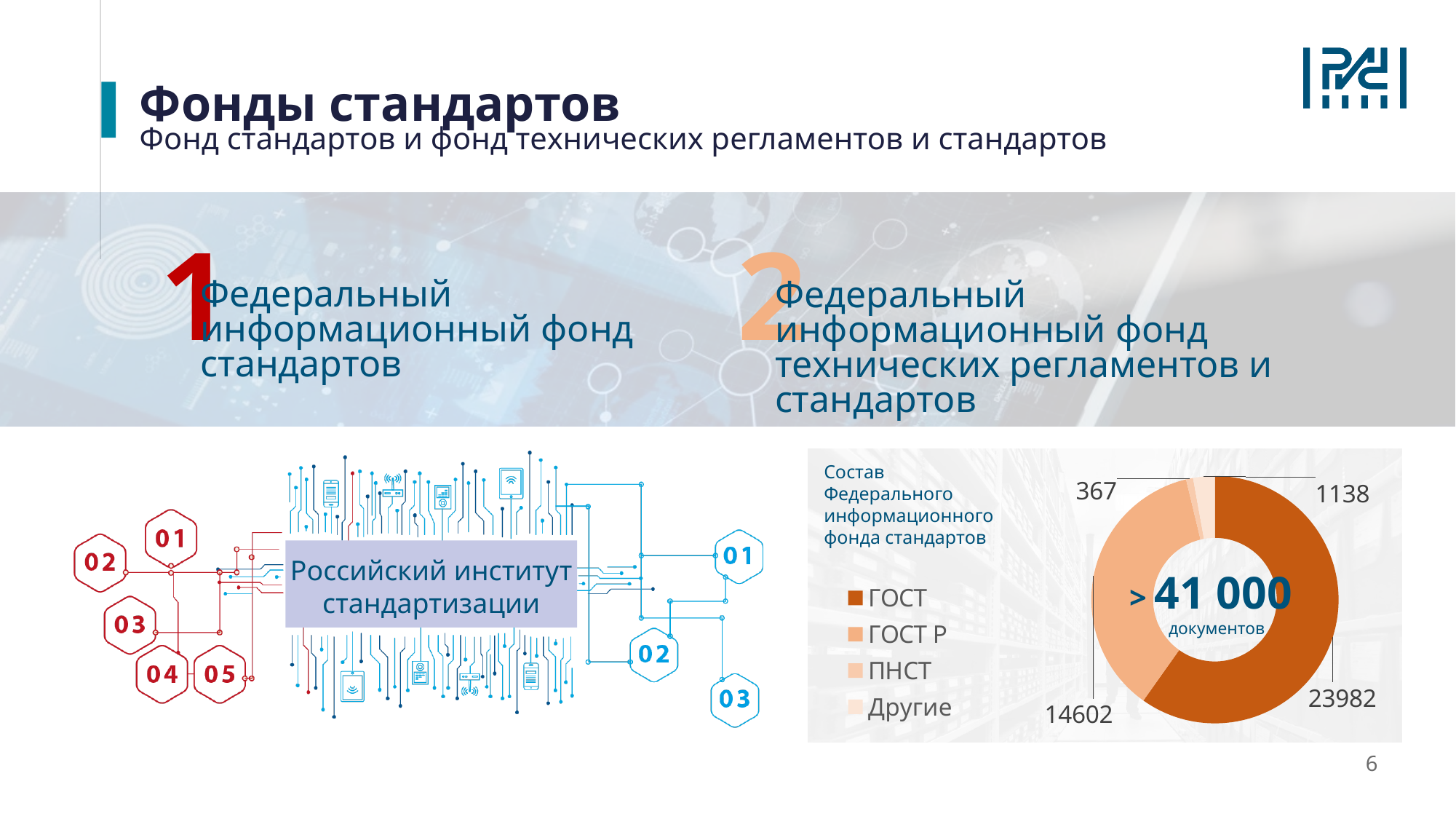
Which category has the largest share of the doughnut chart? ГОСТ What kind of chart is shown on the slide? Doughnut (pie) chart What number of documents is shown in the centre of the doughnut chart? > 41 000 What is the value for ГОСТ in the doughnut chart? 23982 How many data labels are shown around the doughnut chart? 4 What is the title of the doughnut chart? Состав Федерального информационного фонда стандартов What is the smallest value labelled on the doughnut chart? 367 What is the difference between the values for ГОСТ and ГОСТ Р? 9380 Is the value for ГОСТ Р greater or less than 20000? less Which is larger in the doughnut chart, ГОСТ or ГОСТ Р? ГОСТ How many categories does the legend of the doughnut chart list? 4 What is the value for ГОСТ Р in the doughnut chart? 14602